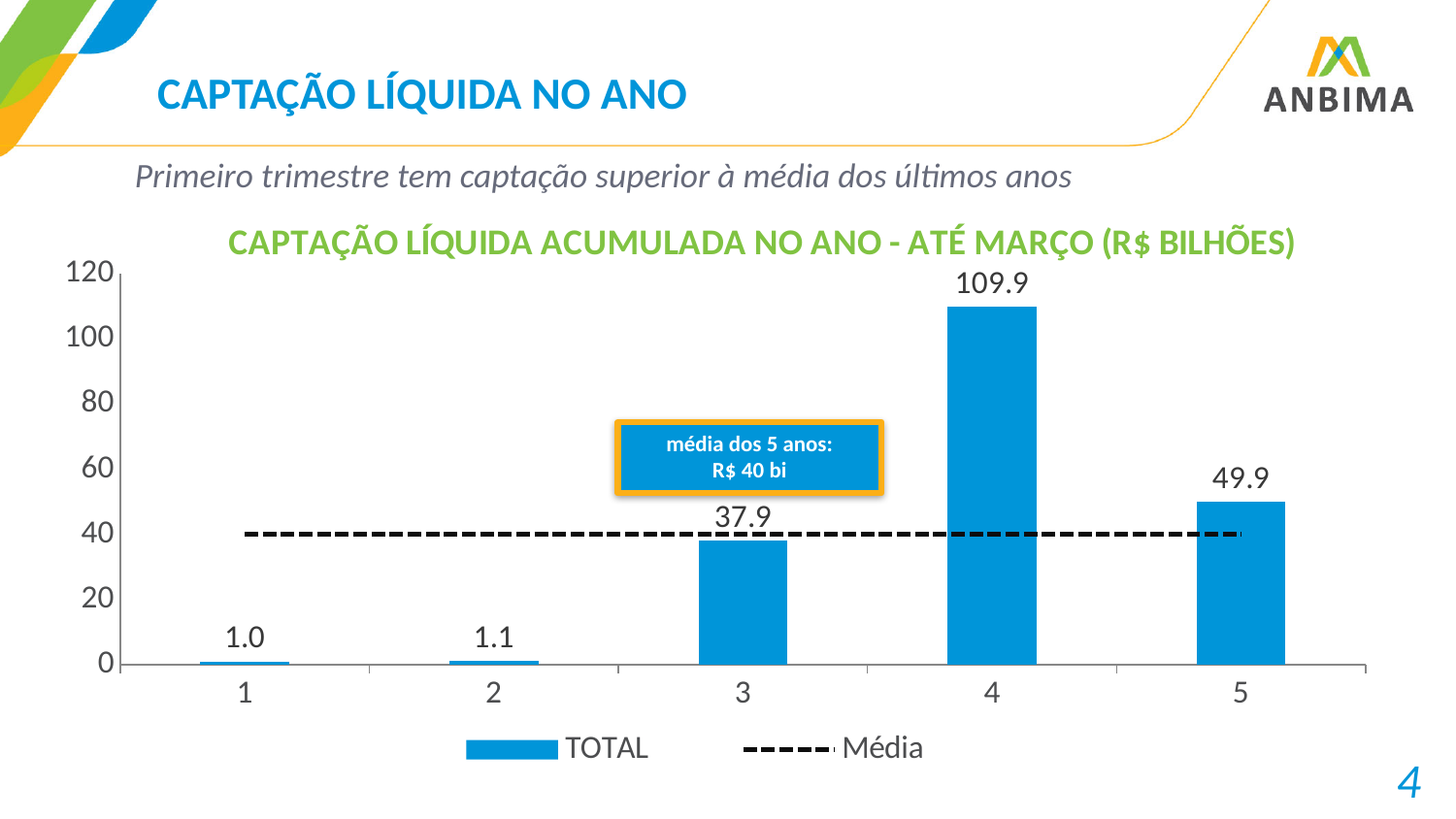
What is the value of the TOTAL bar for category 4? 109.9 What is the value of the TOTAL bar for category 3? 37.9 What value does the text box give for the 5-year average (média dos 5 anos)? R$ 40 bi What is the difference between the TOTAL values for categories 4 and 5? 60.0 Is the TOTAL value for category 4 greater or less than 100? greater What kind of chart is shown on the slide? combination bar and line chart (bars with a dashed average line) Which category has the highest TOTAL value? 4 What is the value of the TOTAL bar for category 1? 1.0 How many series does the legend list? 2 Which is larger, the TOTAL value for category 3 or for category 5? 5 How many categories are shown on the x axis? 5 Which category has the lowest TOTAL value? 1